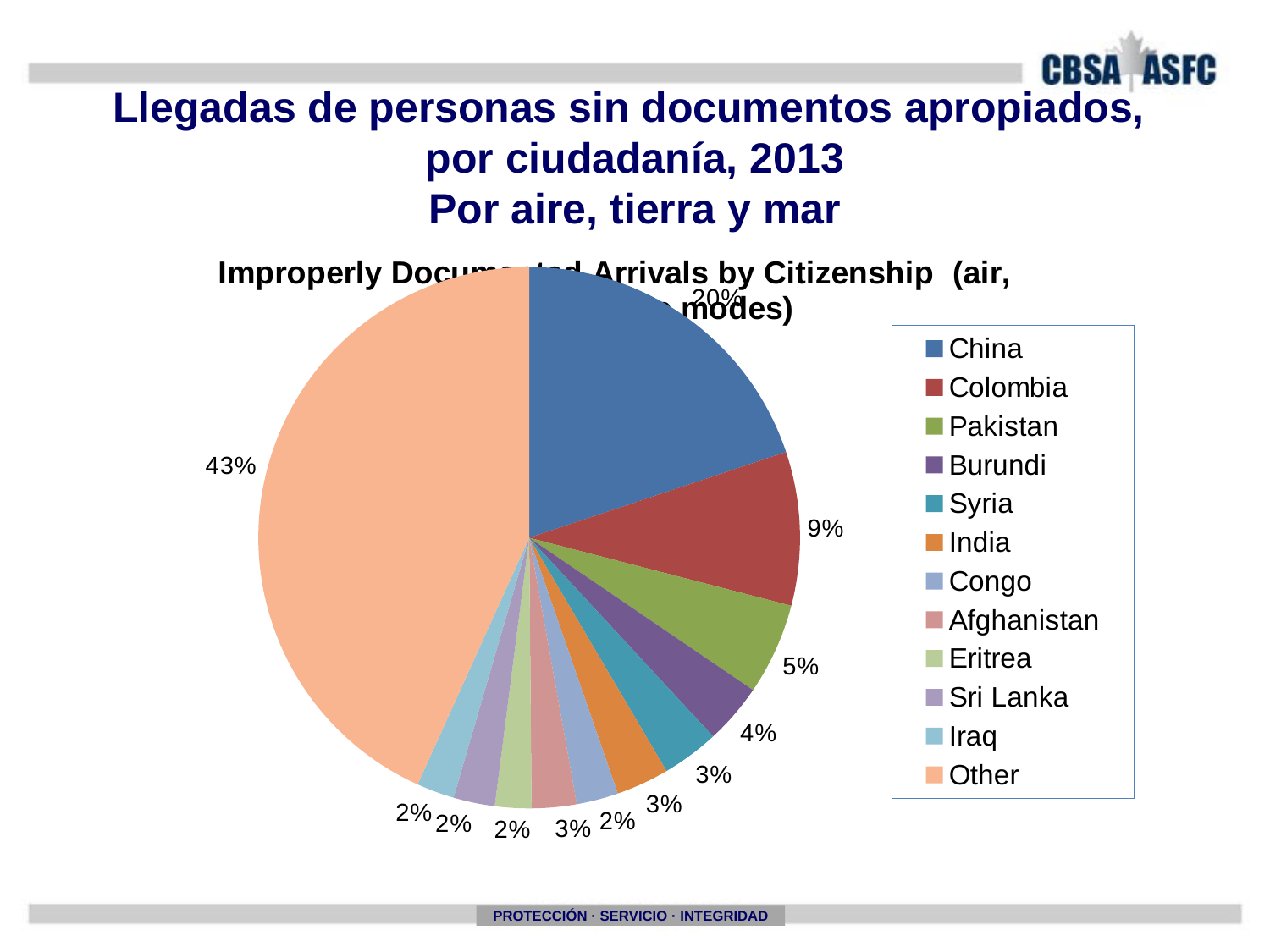
What is the value shown for Other? 43% What is the value shown for Pakistan? 5% What share of the pie does China account for? 20% What is the difference between the shares for Other and China? 23% How many categories are listed in the legend? 12 What is the difference between the shares for China and Colombia? 11% What is the value shown for Colombia? 9% What kind of chart is shown on the slide? pie chart Which category is listed first in the legend? China Which is larger, the slice for Pakistan or the slice for Burundi? Pakistan What is the value shown for Burundi? 4% Which category has the largest slice of the pie? Other